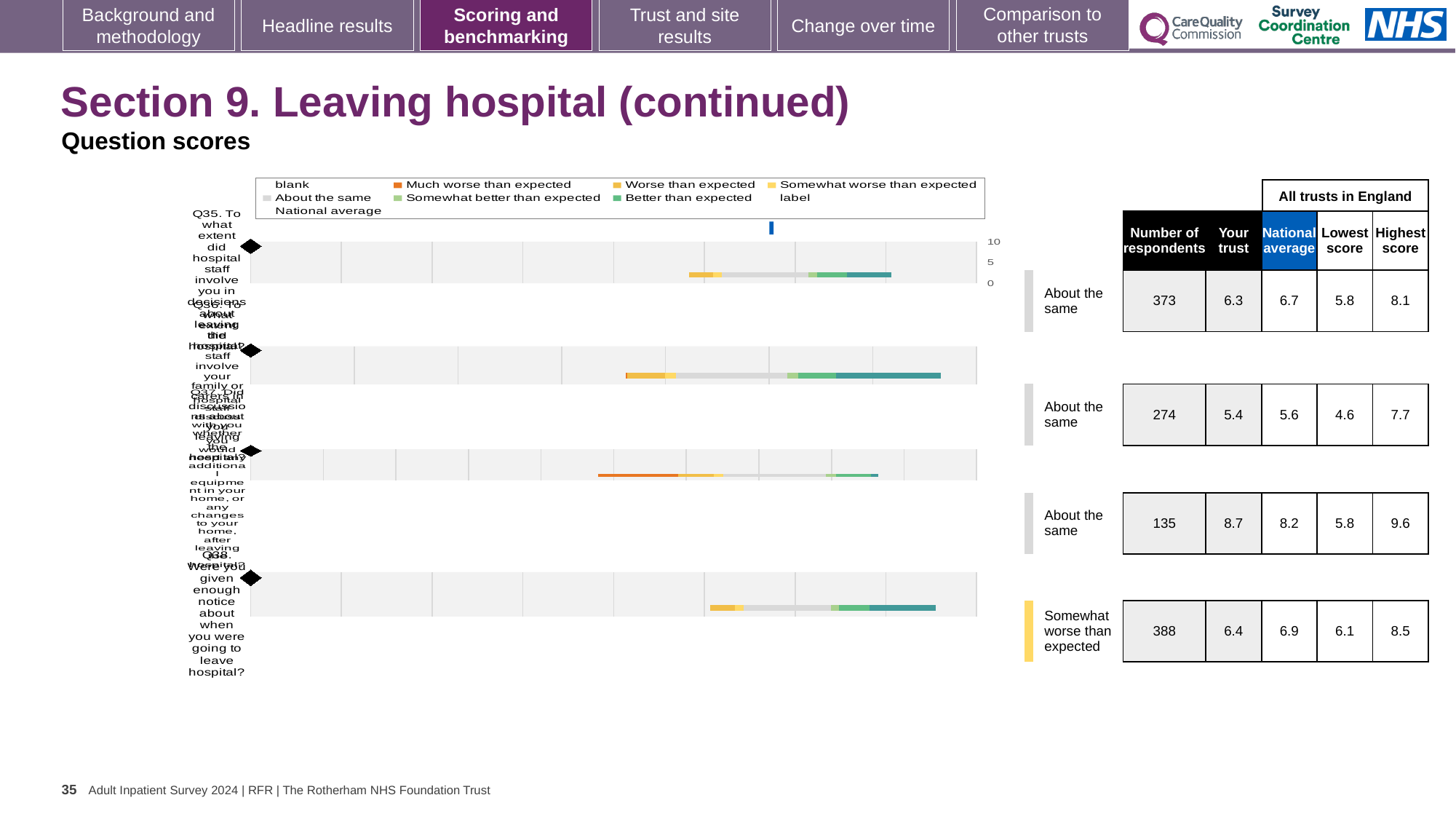
Which question has the highest 'Your trust' score? Q37 Which question has the lowest 'Your trust' score? Q36 Which question has the largest number of respondents? Q38 What is the 'Your trust' score for Q35 (involving you in decisions about leaving hospital)? 6.3 How many respondents answered Q37 (discussing additional equipment or changes to your home)? 135 What kind of chart is shown on the slide? bar chart What is the highest score among all trusts in England for Q38 (enough notice about leaving hospital)? 8.5 What is the national average score for Q36 (involving family or carers in discussions about leaving hospital)? 5.6 How many questions (Q35 to Q38) are plotted as bars in the chart? 4 What is the difference between the 'Your trust' score and the national average for Q37? 0.5 For Q38, is the 'Your trust' score or the national average higher? National average What benchmark category is shown for Q38 (enough notice about leaving hospital)? Somewhat worse than expected